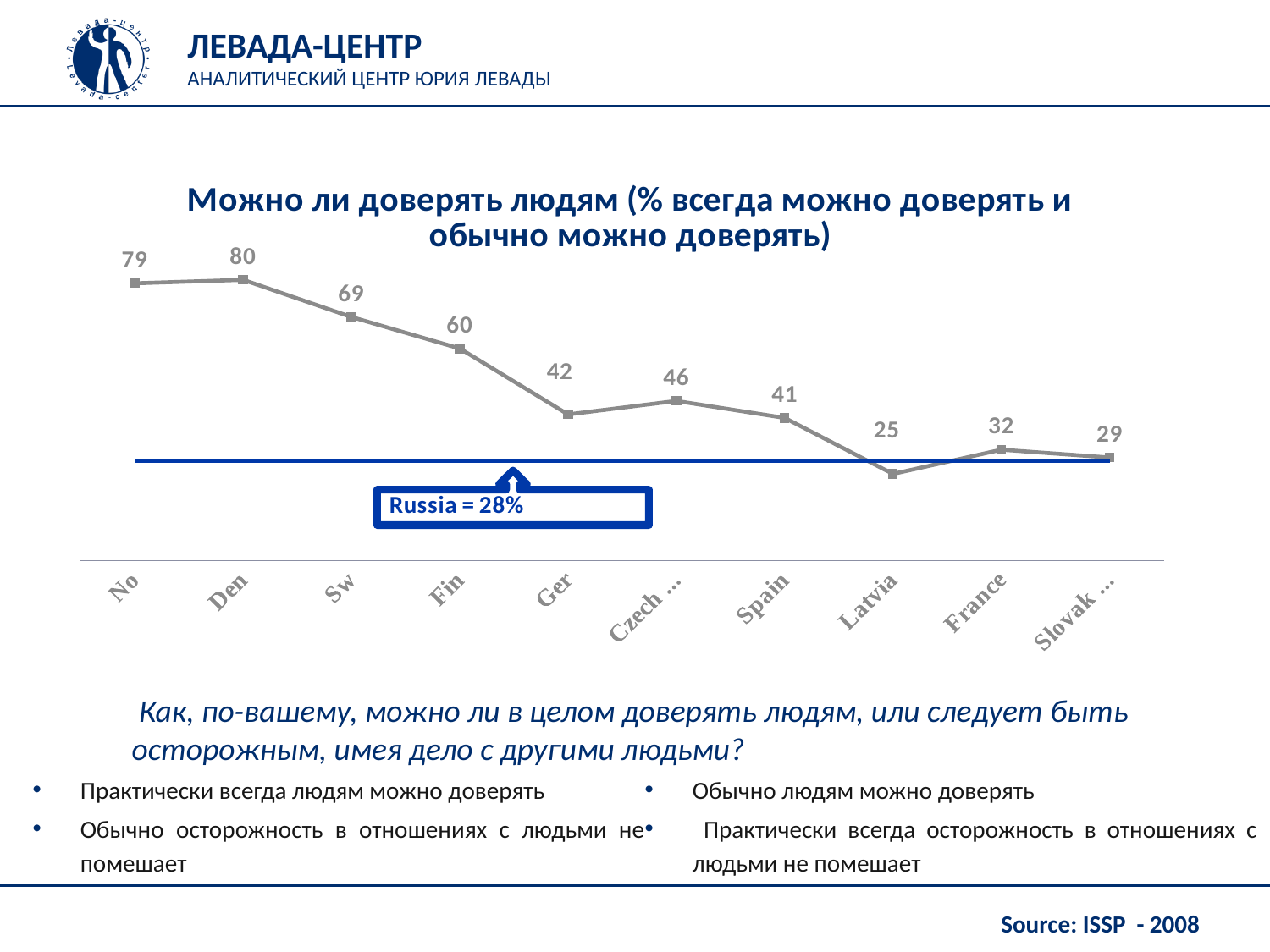
Which category has the highest value? Den What value does the horizontal reference line on the chart represent, according to the callout? Russia = 28% What type of chart is shown on the slide? line chart What is the value for Den? 80 Which category has the lowest value? Latvia What is the value for Latvia? 25 What is the difference between the values for No and Ger? 37 What is the value for France? 32 Which is larger, the value for Spain or the value for the category labelled 'Czech ...'? Czech ... What is the difference between the values for Sw and France? 37 How many categories are plotted on the x axis? 10 What is the value for Fin? 60